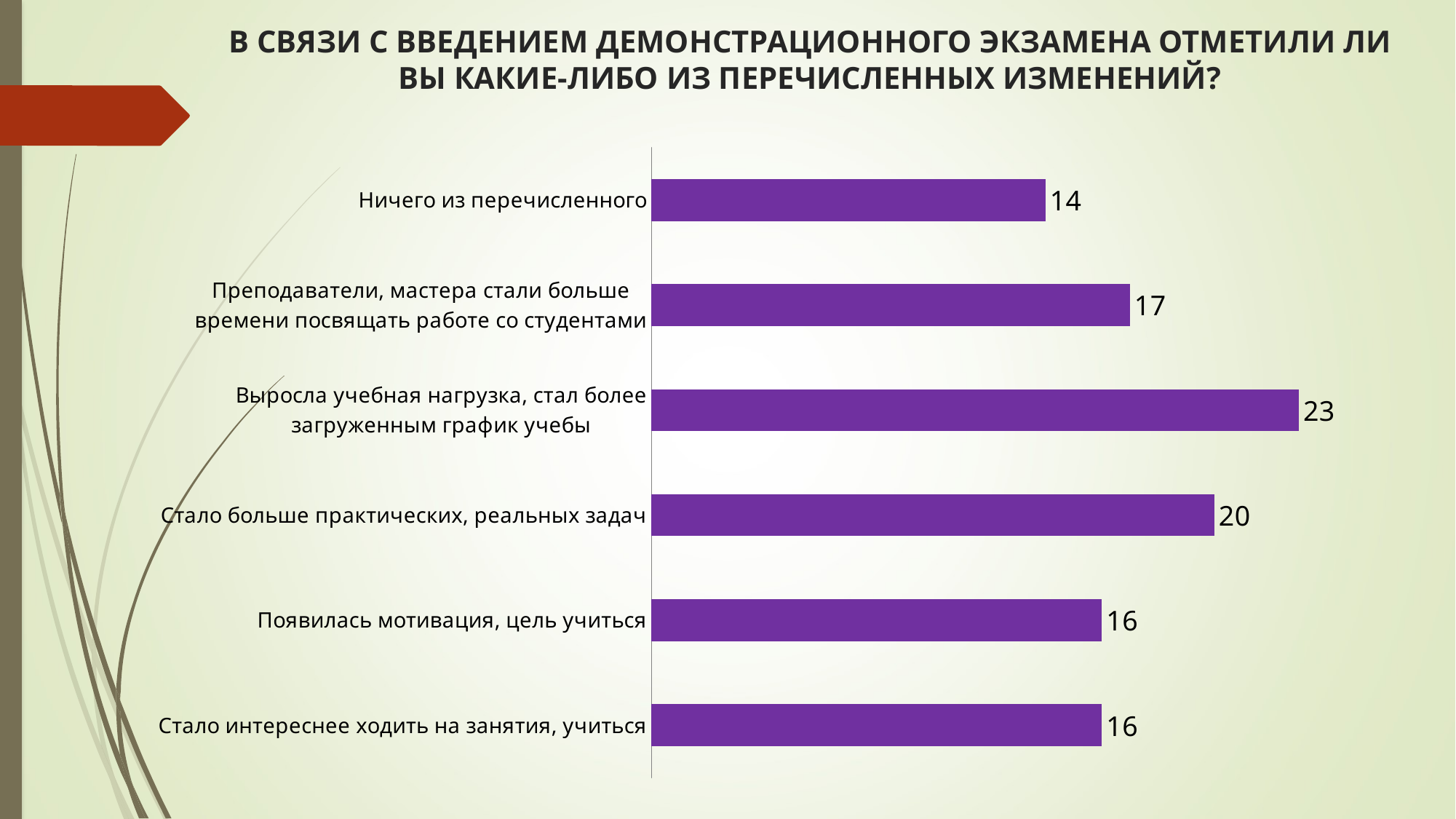
Which category has the lowest value? Ничего из перечисленного Which category has the highest value? Выросла учебная нагрузка, стал более загруженным график учебы What is the value for "Стало больше практических, реальных задач"? 20 What is the value for "Выросла учебная нагрузка, стал более загруженным график учебы"? 23 What is the value for "Преподаватели, мастера стали больше времени посвящать работе со студентами"? 17 What is the difference between the values for "Выросла учебная нагрузка, стал более загруженным график учебы" and "Ничего из перечисленного"? 9 What is the value for "Ничего из перечисленного"? 14 What colour are the bars in the chart? purple What is the difference between the values for "Стало больше практических, реальных задач" and "Появилась мотивация, цель учиться"? 4 Which is larger: the value for "Стало больше практических, реальных задач" or the value for "Преподаватели, мастера стали больше времени посвящать работе со студентами"? Стало больше практических, реальных задач How many categories are shown in the chart? 6 What kind of chart is shown on the slide? bar chart